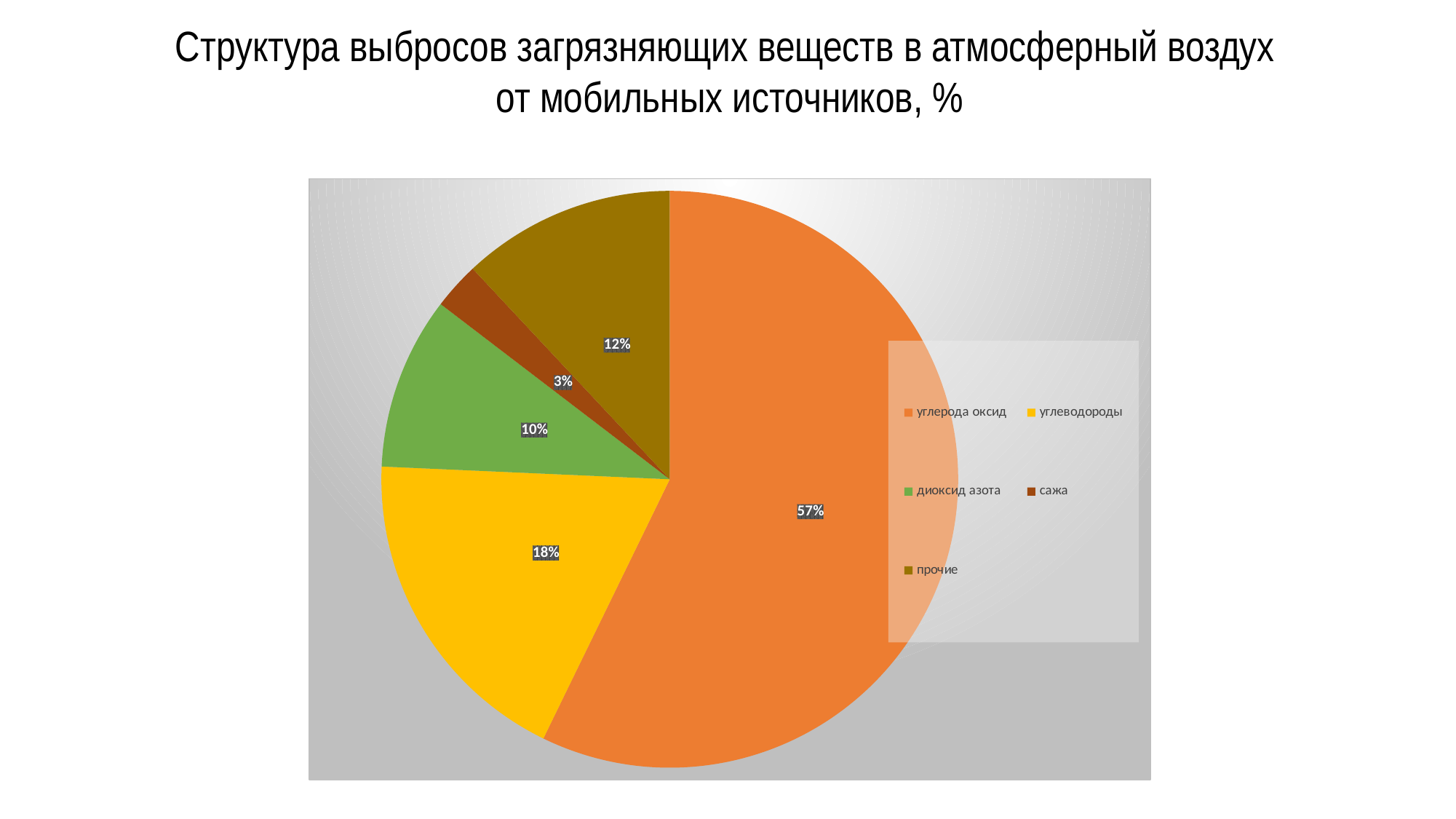
What share of emissions is attributed to диоксид азота? 10% Which category has the largest share of the pie? углерода оксид What is the title of the chart on the slide? Структура выбросов загрязняющих веществ в атмосферный воздух от мобильных источников, % Which is larger, the share of прочие or the share of диоксид азота? прочие What is the difference between the shares of углерода оксид and углеводороды? 39% What share of emissions is attributed to прочие? 12% What share of emissions is attributed to углерода оксид? 57% Which category has the smallest share of the pie? сажа What share of emissions is attributed to углеводороды? 18% What kind of chart is shown on the slide? pie chart What share of emissions is attributed to сажа? 3% How many categories does the pie chart have? 5